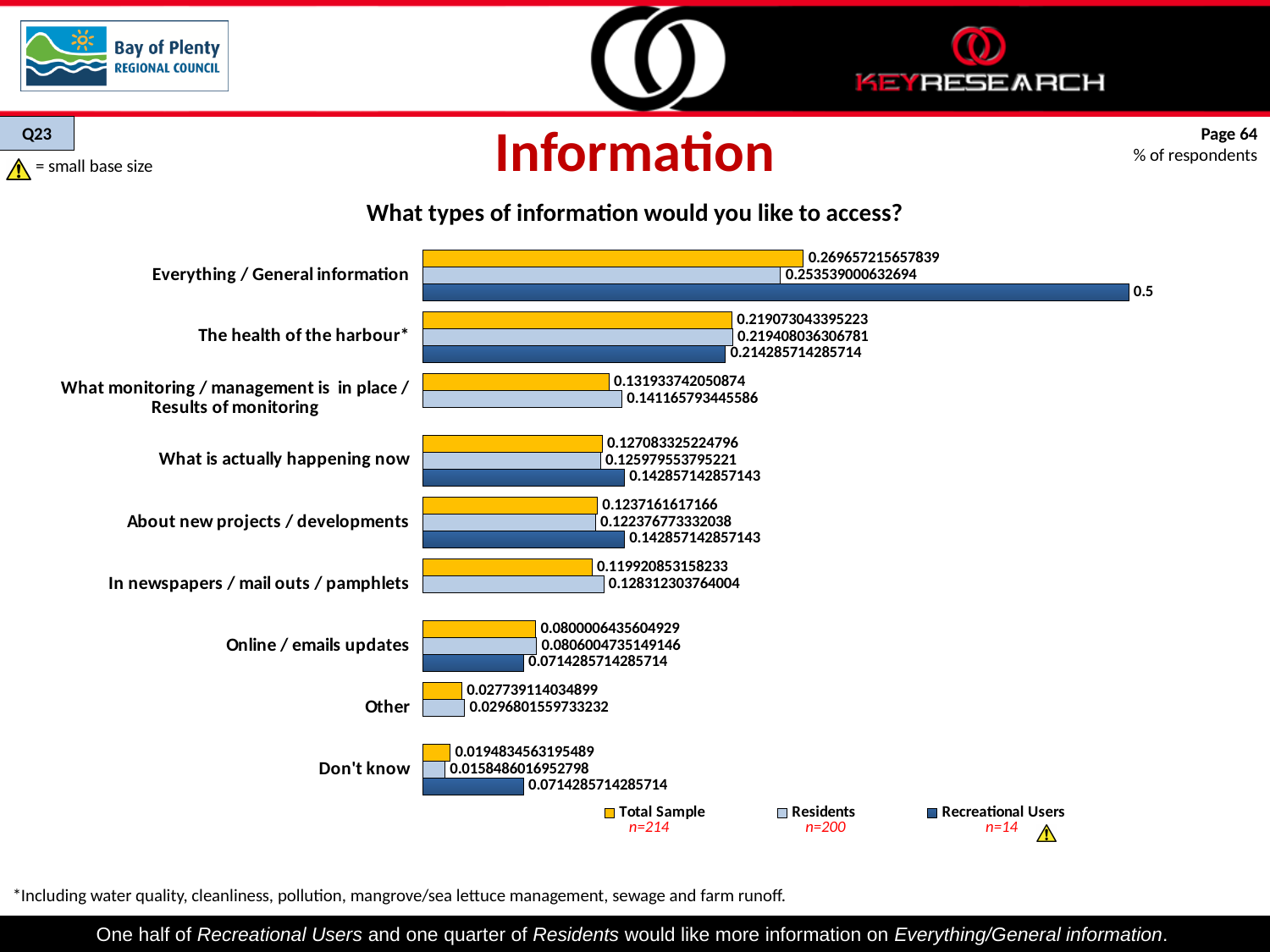
What is the Recreational Users value for 'Everything / General information'? 0.5 What type of chart is shown on the slide? Bar chart How many categories are shown on the chart? 9 What is the Residents value for 'Online / emails updates'? 0.0806004735149146 What is the question shown as the chart title? What types of information would you like to access? What is the Total Sample value for 'The health of the harbour*'? 0.219073043395223 What is the Recreational Users value for 'Don't know'? 0.0714285714285714 For 'Everything / General information', which is larger: the Total Sample value or the Recreational Users value? Recreational Users What is the sample size (n) shown for Recreational Users in the legend? n=14 How many series does the legend list? 3 Which category has the highest Recreational Users value? Everything / General information Which category has the lowest Total Sample value? Don't know